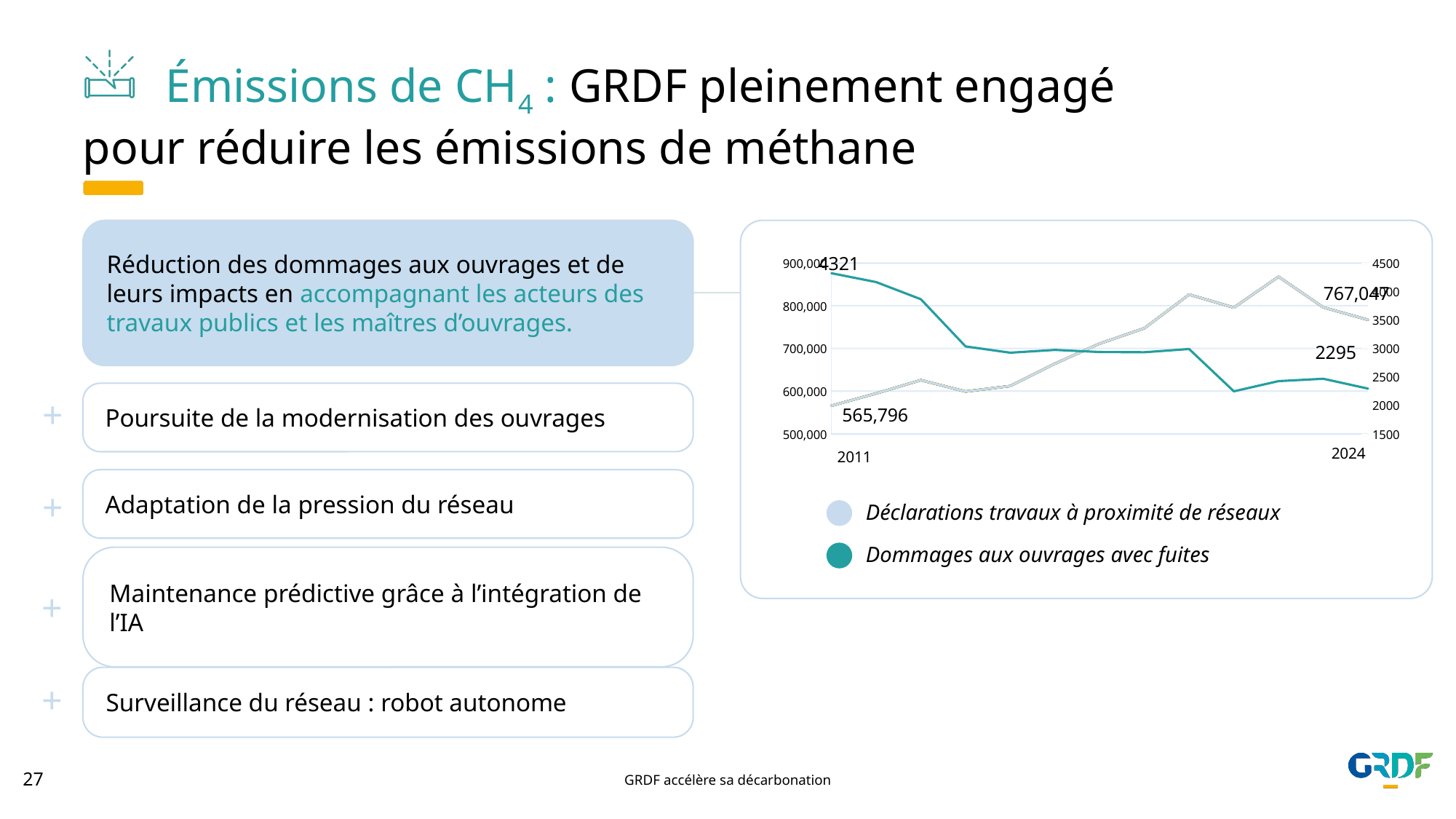
How many series does the chart's legend list? 2 What kind of chart is shown on the slide? line chart What is the value of Dommages aux ouvrages avec fuites in 2011? 4321 What is the value of Dommages aux ouvrages avec fuites in 2024? 2295 By how much did Déclarations travaux à proximité de réseaux increase between 2011 and 2024? 201,251 Does the Déclarations travaux à proximité de réseaux line rise or fall overall from 2011 to 2024? rise What is the value of Déclarations travaux à proximité de réseaux in 2024? 767,047 Does the Dommages aux ouvrages avec fuites line rise or fall overall from 2011 to 2024? fall By how much did Dommages aux ouvrages avec fuites decrease between 2011 and 2024? 2026 Which series is drawn in the teal (dark green-blue) colour? Dommages aux ouvrages avec fuites For Dommages aux ouvrages avec fuites, which year has the larger value, 2011 or 2024? 2011 What is the value of Déclarations travaux à proximité de réseaux in 2011? 565,796